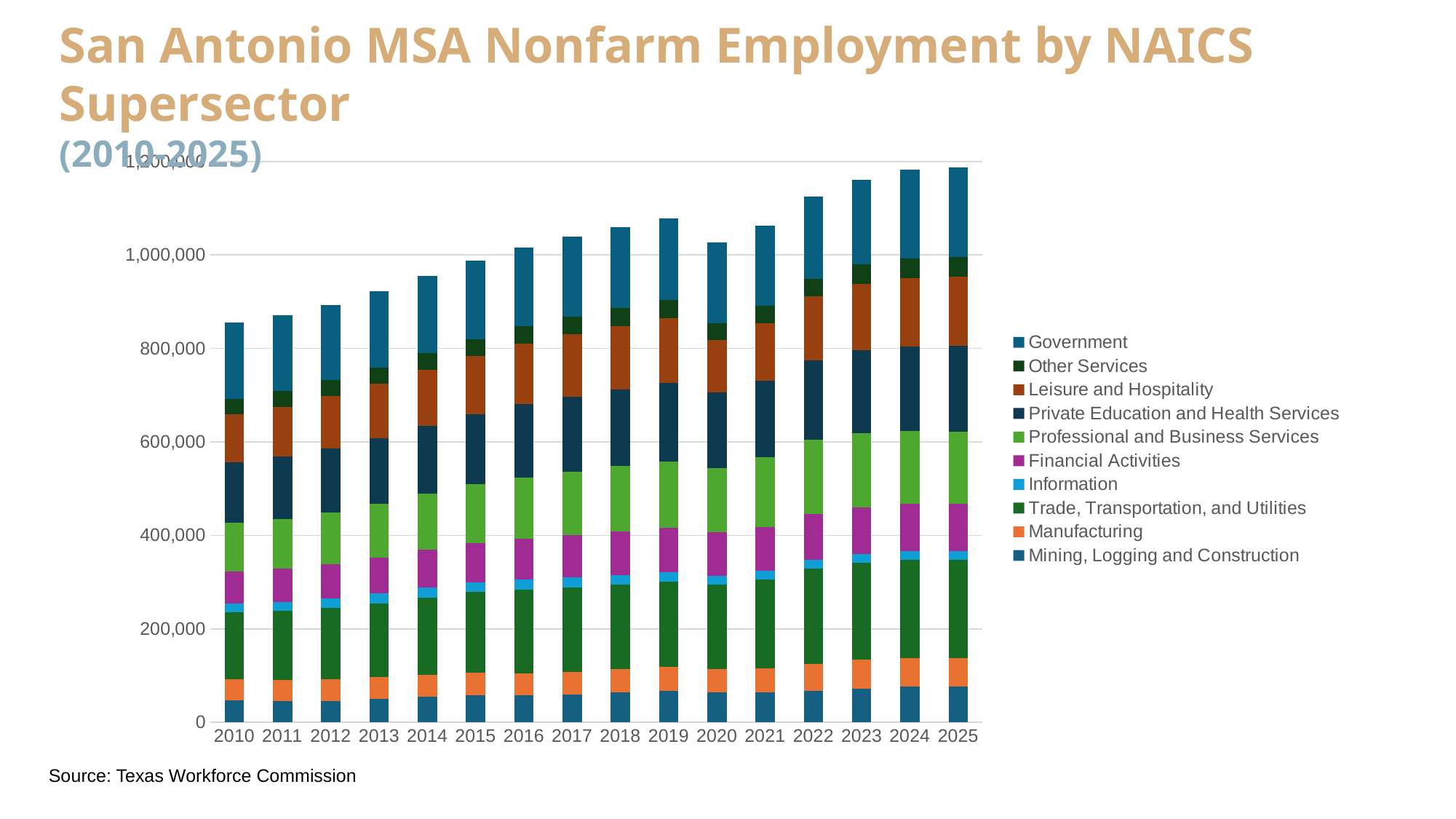
Which year has the larger total employment, 2019 or 2020? 2019 What kind of chart is shown on the slide? Stacked bar chart Which year has the larger total employment, 2021 or 2022? 2022 How many series does the legend list? 10 Which series is listed first in the legend? Government How many years are shown along the x axis of the chart? 16 Is the total employment for 2025 greater or less than 1,000,000? greater Is the total employment for 2022 greater or less than 1,000,000? greater Which year has the lowest total nonfarm employment? 2010 Is the total employment for 2010 greater or less than 1,000,000? less What is the source cited for the chart data? Texas Workforce Commission Do total employment values generally rise or fall from 2010 to 2025? Rise